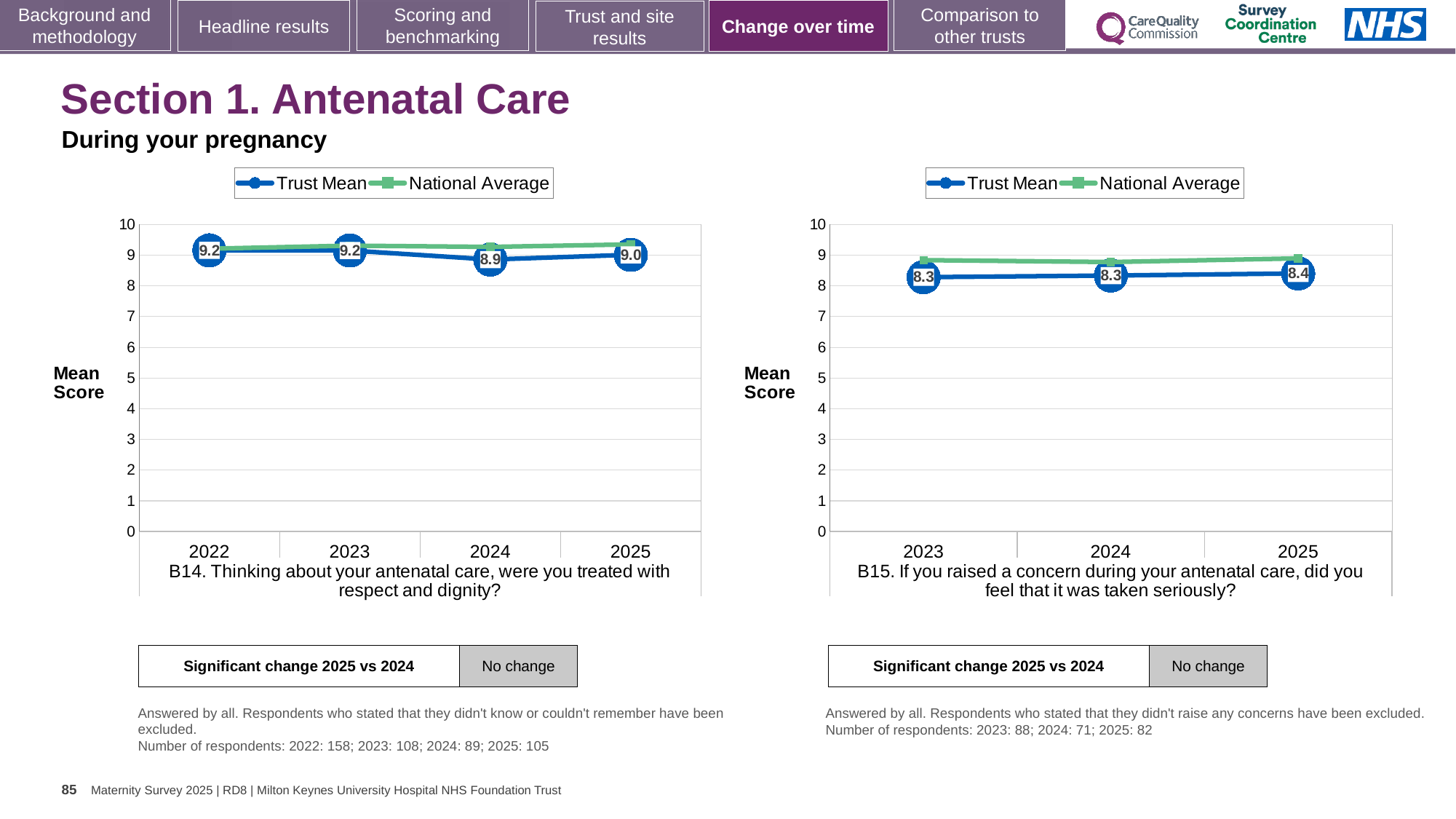
In the B14 chart (left), what is the Trust Mean score for 2025? 9.0 In the B15 chart (right), what is the Trust Mean score for 2025? 8.4 In the B14 chart (left), what is the difference between the Trust Mean scores for 2023 and 2024? 0.3 How many years are plotted on the x axis of the B15 chart (right)? 3 In the B14 chart (left), what is the Trust Mean score for 2022? 9.2 In the B14 chart (left), what is the Trust Mean score for 2024? 8.9 What type of chart is the B14 chart (left)? Line chart How many series does the legend of the B14 chart (left) list? 2 In the B14 chart (left), is the Trust Mean score for 2022 larger or smaller than the Trust Mean score for 2025? larger In the B15 chart (right), what is the Trust Mean score for 2023? 8.3 In the B14 chart (left), which year has the lowest Trust Mean score? 2024 In the B15 chart (right), is the National Average value for 2024 greater or less than 8? greater